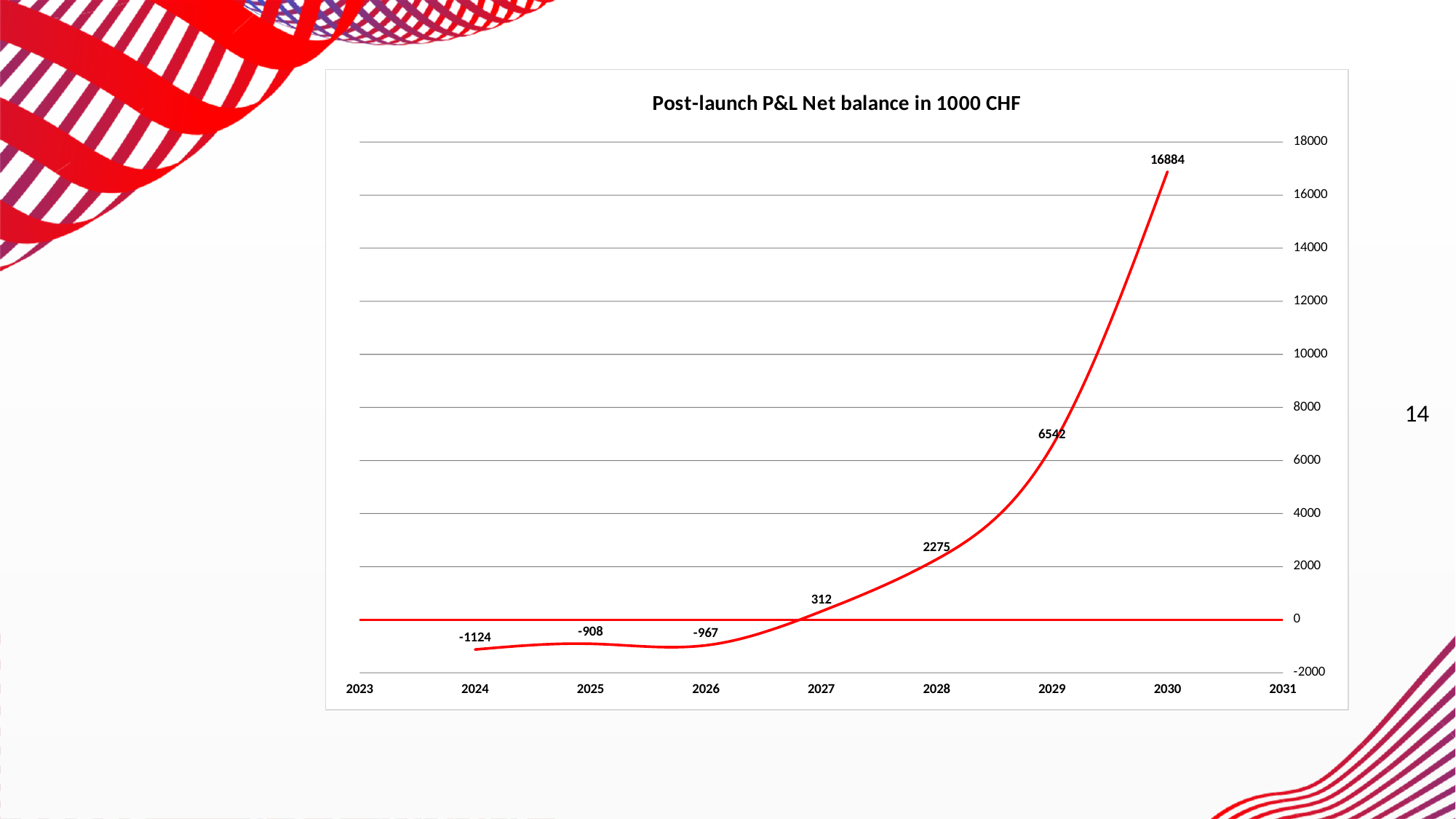
What is the title of the chart? Post-launch P&L Net balance in 1000 CHF What is the value for 2030? 16884 How many data points are labelled on the line? 7 Which year has the lowest value? 2024 Which is larger, the value for 2025 or the value for 2026? 2025 Do the values generally rise or fall from 2026 to 2030? Rise What kind of chart is this? Line chart What is the value for 2028? 2275 What is the value for 2027? 312 Which year has the highest value? 2030 What is the value for 2024? -1124 What is the difference between the values for 2030 and 2029? 10342